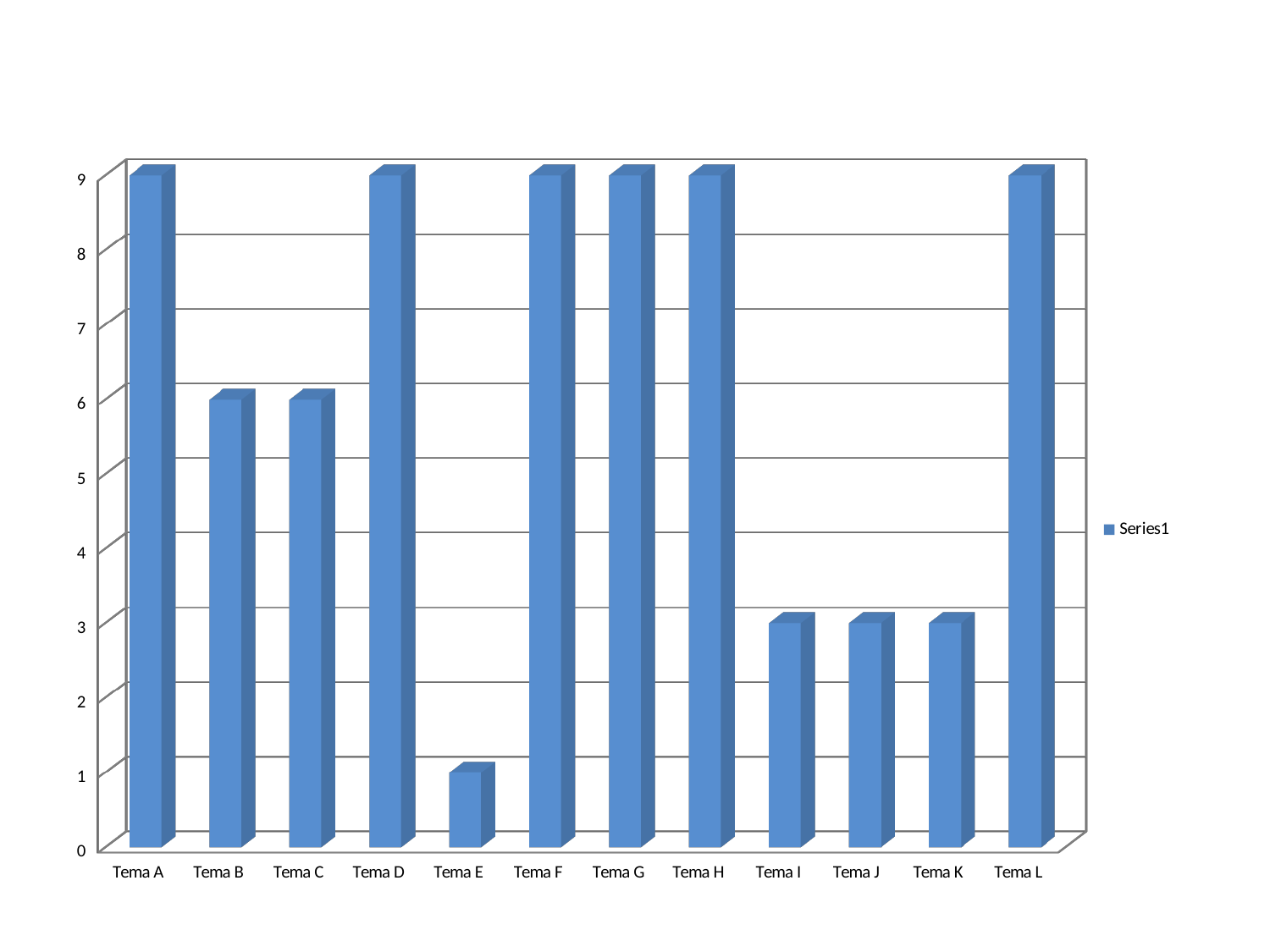
What is the value for Tema E? 1 What is the value for Tema B? 6 Which category has the lowest value? Tema E What is the difference between the values for Tema D and Tema J? 6 What kind of chart is shown on the slide? bar chart What is the value for Tema I? 3 How many series does the legend list? 1 Which is larger, the value for Tema C or the value for Tema K? Tema C What is the value for Tema L? 9 Is the value for Tema H greater or less than 5? greater How many categories are shown on the x axis? 12 What is the name of the series shown in the legend? Series1